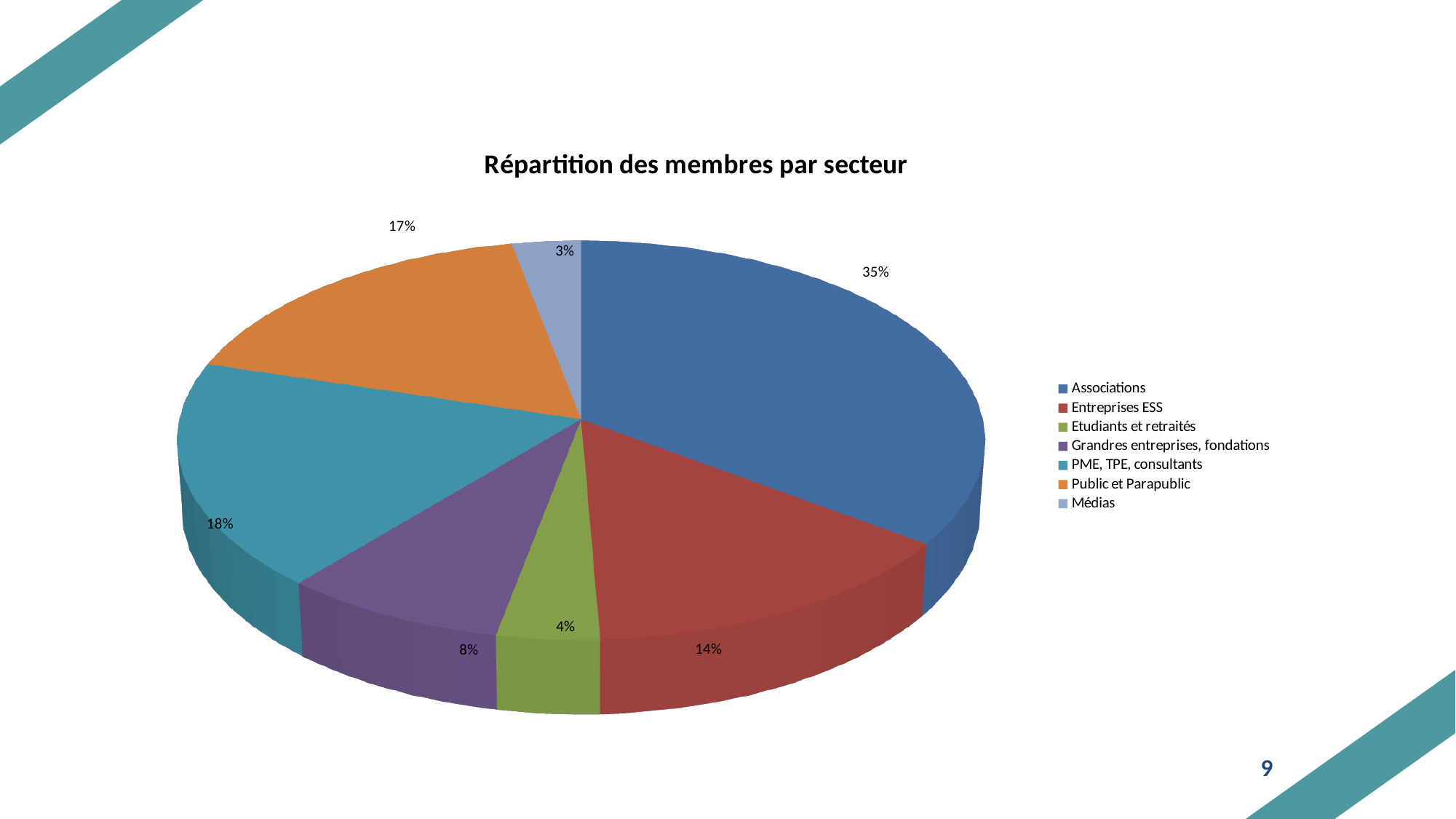
How many sectors does the legend list? 7 What share of members is in the PME, TPE, consultants sector? 18% What is the difference between the shares of Associations and Entreprises ESS? 21% What share of members is in the Public et Parapublic sector? 17% Which sector has the largest share of members? Associations What is the title of the chart? Répartition des membres par secteur What share of members is in the Médias sector? 3% What share of members is in the Associations sector? 35% What share of members is in the Entreprises ESS sector? 14% What type of chart is shown on the slide? Pie chart Which has a larger share, Grandres entreprises, fondations or Etudiants et retraités? Grandres entreprises, fondations Which sector has the smallest share of members? Médias